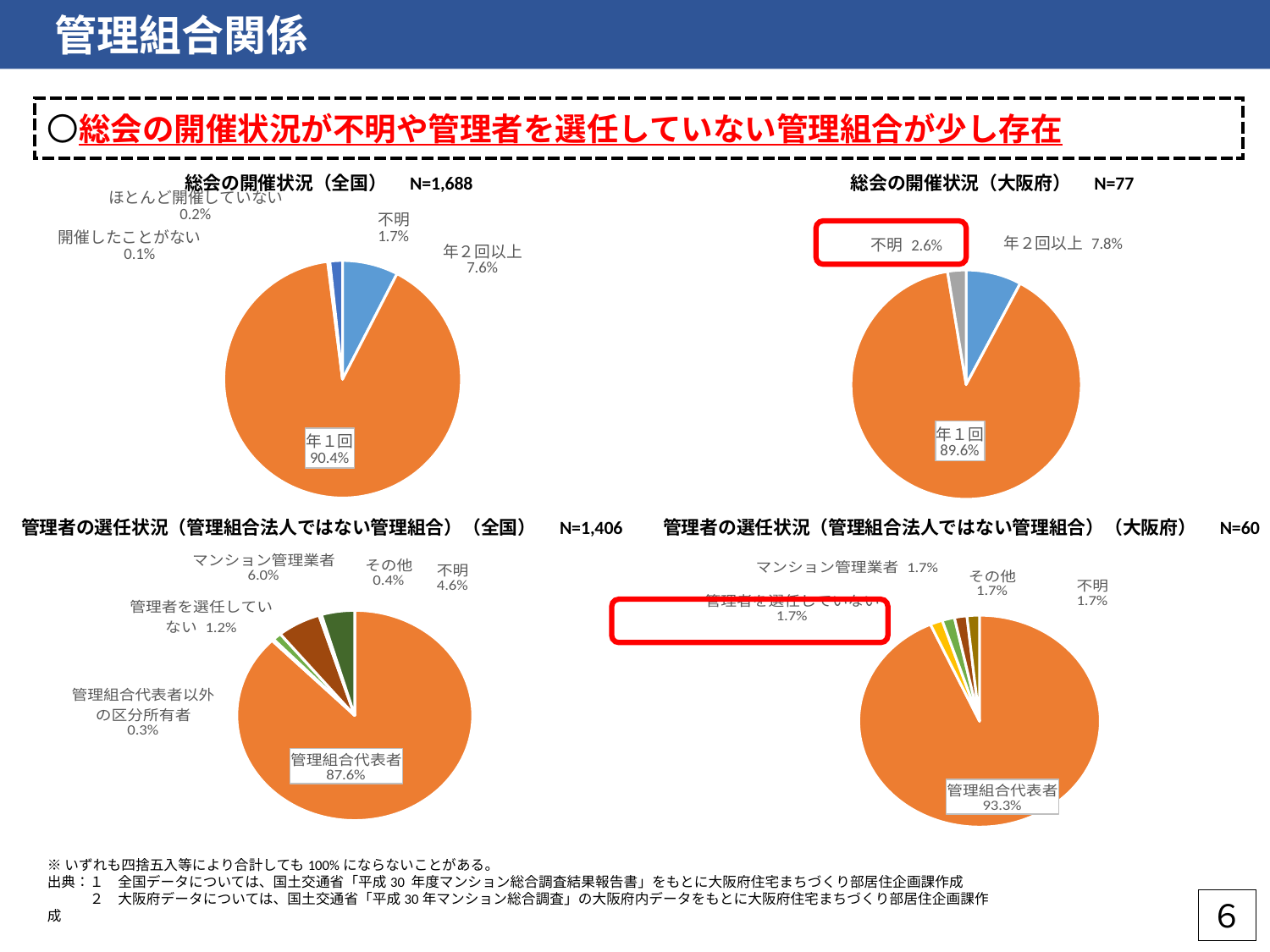
「総会の開催状況（大阪府）」のグラフはどの種類のグラフですか。 円グラフ 「管理者の選任状況（管理組合法人ではない管理組合）（全国）」の円グラフには、いくつの項目がありますか。 6 「管理者の選任状況（管理組合法人ではない管理組合）（大阪府）」の円グラフで、「管理組合代表者」の割合はいくらですか。 93.3% 「総会の開催状況（大阪府）」の円グラフで、「年２回以上」の割合はいくらですか。 7.8% 「総会の開催状況（全国）」の円グラフで、「年１回」の割合はいくらですか。 90.4% 「総会の開催状況（全国）」の円グラフで、「年２回以上」と「不明」の割合の差はいくらですか。 5.9% 「管理者の選任状況（管理組合法人ではない管理組合）（全国）」の円グラフで、「マンション管理業者」の割合はいくらですか。 6.0% 「管理者の選任状況（管理組合法人ではない管理組合）（大阪府）」の円グラフで、「管理者を選任していない」の割合はいくらですか。 1.7% 「総会の開催状況（全国）」の円グラフで、最も割合が小さい項目はどれですか。 開催したことがない 「総会の開催状況（大阪府）」のグラフのサンプル数（N）はいくつですか。 N=77 「管理者の選任状況（管理組合法人ではない管理組合）（全国）」の円グラフで、「不明」と「管理者を選任していない」ではどちらの割合が大きいですか。 不明 「総会の開催状況（大阪府）」の円グラフで、「不明」の割合はいくらですか。 2.6%